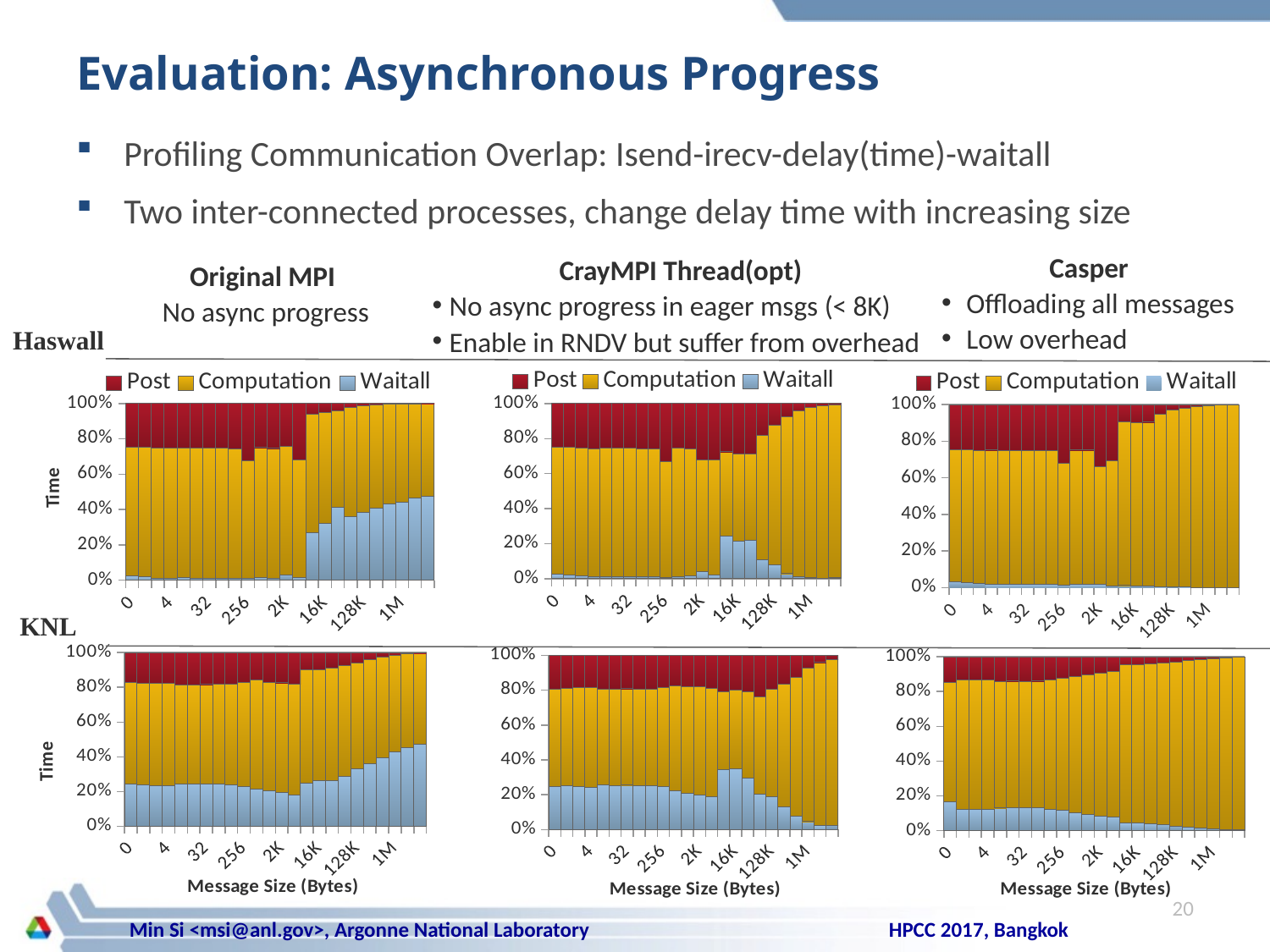
In the KNL Casper chart, does the Waitall share rise or fall as message size increases along the x axis? fall In the Haswell Original MPI chart, does the Waitall share rise or fall from message size 16K to 1M? rise In the KNL Casper chart, is the Waitall share at message size 1M greater or less than 20%? less What are the three series named in the legend of the Haswell CrayMPI Thread(opt) chart? Post, Computation, Waitall What is the x-axis title of the KNL Original MPI chart? Message Size (Bytes) How many series does the legend list for the Haswell Casper chart? 3 How many message size labels are shown on the x axis of the KNL Casper chart? 8 In the KNL Original MPI chart, is the Waitall share at message size 0 greater or less than 40%? less In the Haswell Original MPI chart, is the Waitall share at message size 1M greater or less than 20%? greater What type of chart is used for the Haswell Original MPI panel? Stacked bar chart